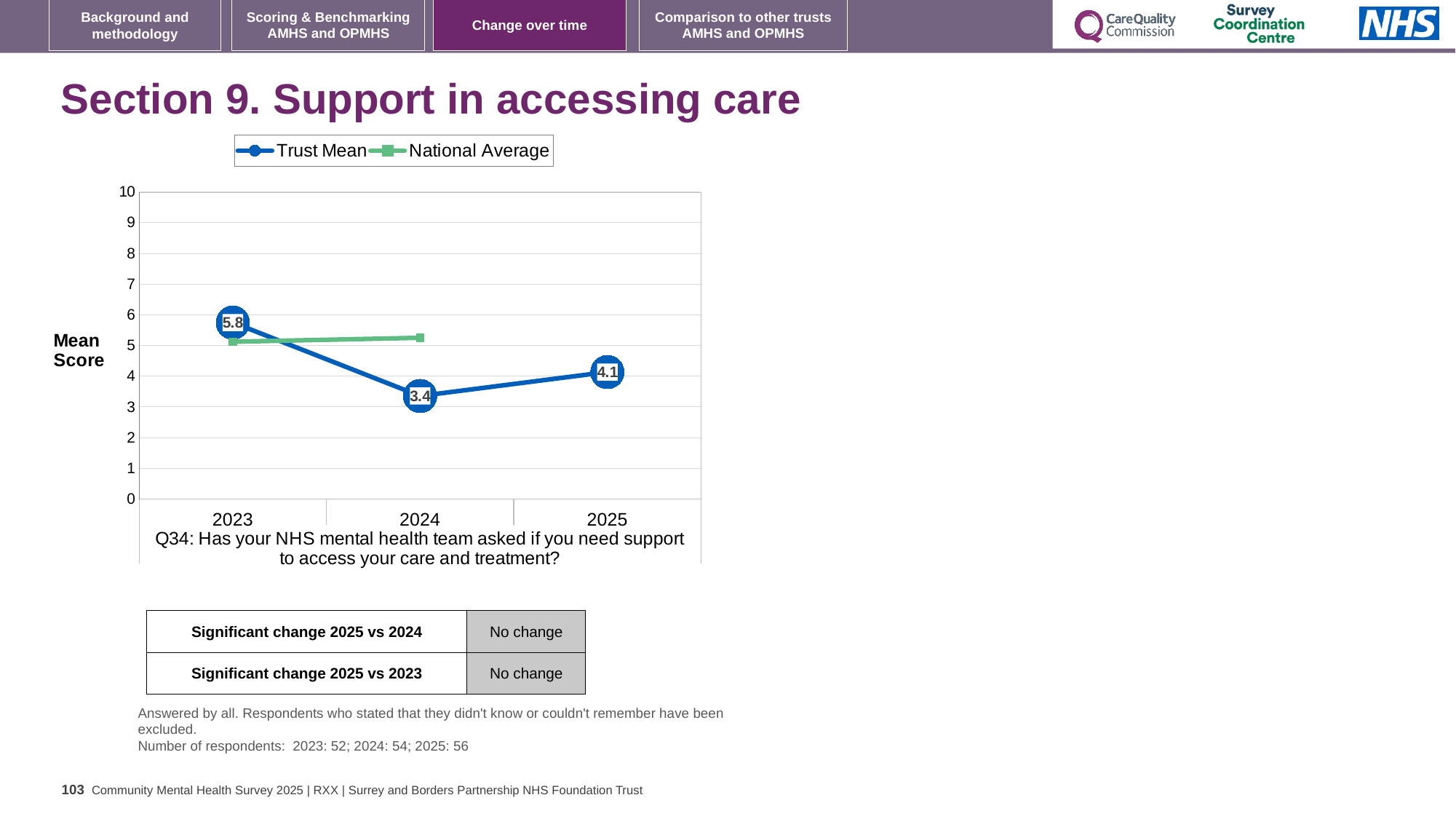
What is the Trust Mean score for 2025? 4.1 How many years are shown on the x axis? 3 In which year is the Trust Mean score lowest? 2024 Does the Trust Mean score rise or fall from 2023 to 2024? Fall In which year is the Trust Mean score highest? 2023 What is the Trust Mean score for 2023? 5.8 What is the Trust Mean score for 2024? 3.4 What is the difference between the Trust Mean scores for 2023 and 2024? 2.4 Which is larger, the Trust Mean score for 2023 or for 2025? 2023 Is the National Average value for 2024 greater or less than 6? less How many series does the legend list? 2 What kind of chart is shown on the slide? Line chart